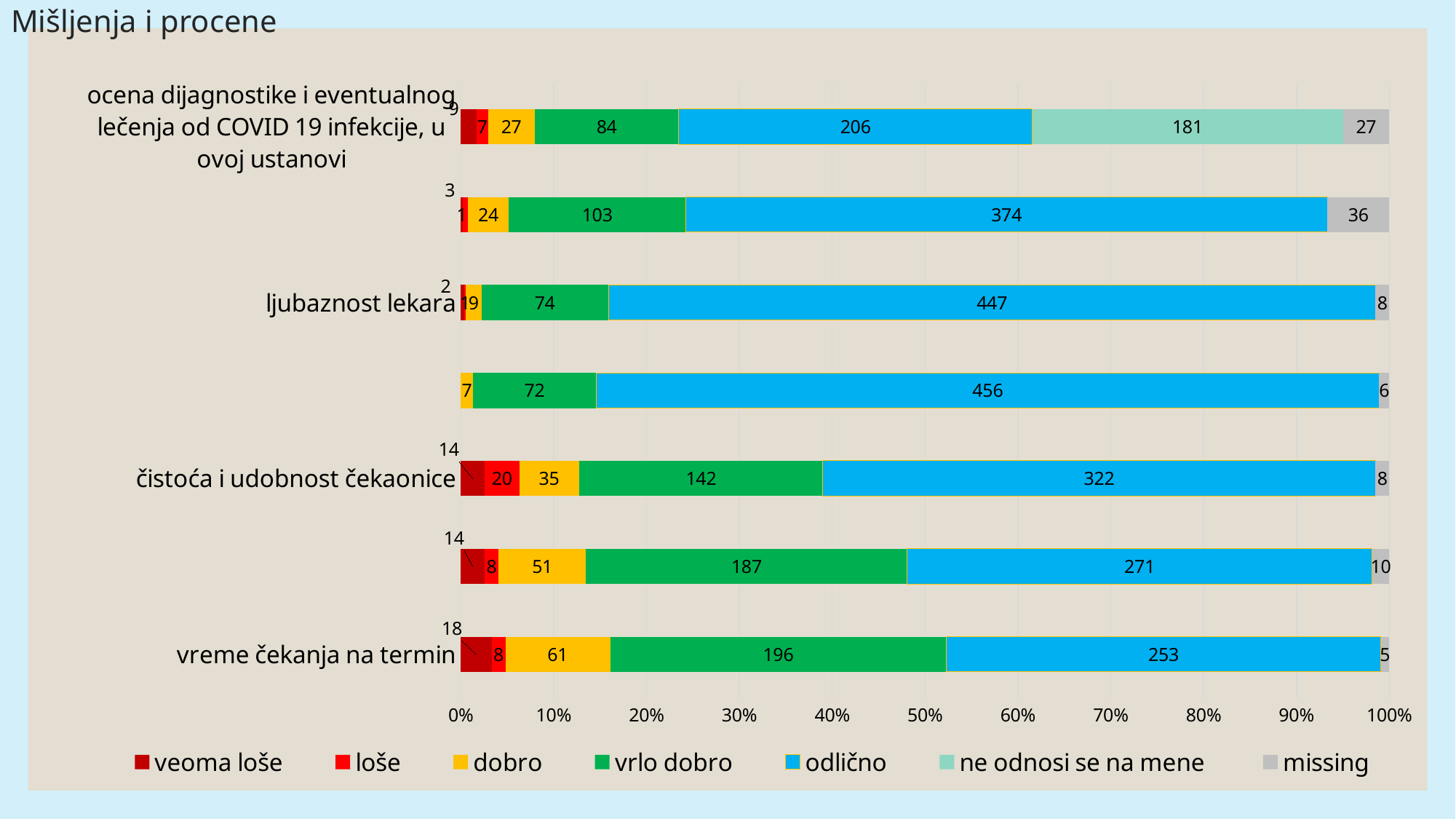
What is the difference between the 'odlično' values for 'ljubaznost lekara' and 'čistoća i udobnost čekaonice'? 125 What is the title of the slide? Mišljenja i procene What is the value for 'vrlo dobro' in the 'čistoća i udobnost čekaonice' bar? 142 Which series has the largest value in the 'vreme čekanja na termin' bar? odlično What kind of chart is shown on the slide? bar chart What is the value for 'odlično' in the 'ljubaznost lekara' bar? 447 Which is larger: 'vrlo dobro' for 'vreme čekanja na termin' or 'vrlo dobro' for 'čistoća i udobnost čekaonice'? vreme čekanja na termin What is the value for 'ne odnosi se na mene' in the 'ocena dijagnostike i eventualnog lečenja od COVID 19 infekcije, u ovoj ustanovi' bar? 181 What is the value for 'loše' in the 'čistoća i udobnost čekaonice' bar? 20 What is the total of all labelled values in the 'vreme čekanja na termin' bar? 541 How many series does the legend list? 7 What is the value for 'odlično' in the 'vreme čekanja na termin' bar? 253